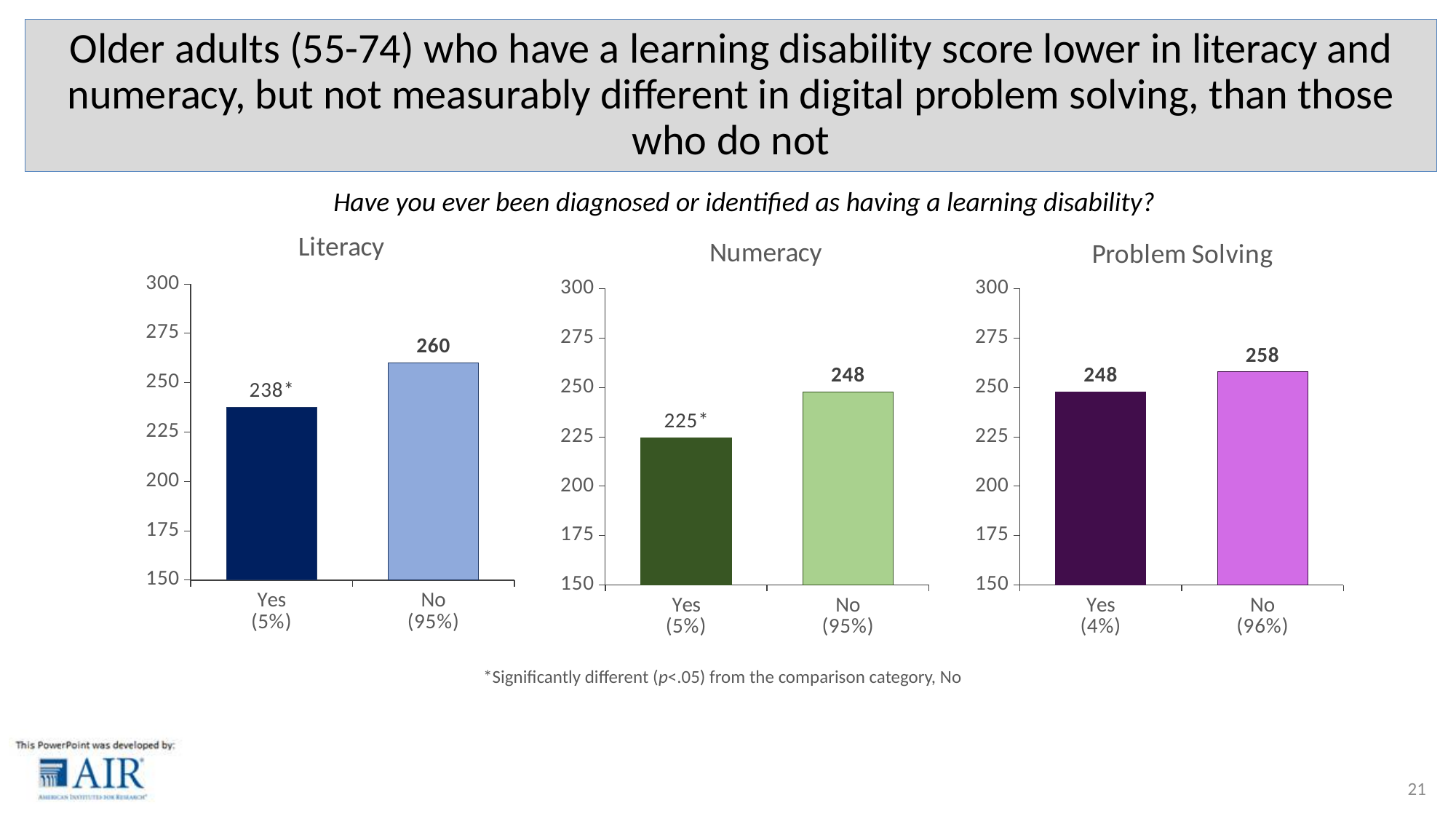
In the Numeracy chart, which category has the lowest value? Yes In the Numeracy chart, what is the difference between the No and Yes values? 23 In the Literacy chart, what is the value for No? 260 In the Literacy chart, what is the difference between the No and Yes values? 22 In the Numeracy chart, what is the value for No? 248 How many categories are shown in the Problem Solving chart? 2 In the Problem Solving chart, which category has the higher value, Yes or No? No In the Problem Solving chart, what is the value for Yes? 248 In the Problem Solving chart, what is the value for No? 258 In the Literacy chart, what is the value for Yes? 238 In the Numeracy chart, what is the value for Yes? 225 What kind of chart is the Literacy chart? Bar chart